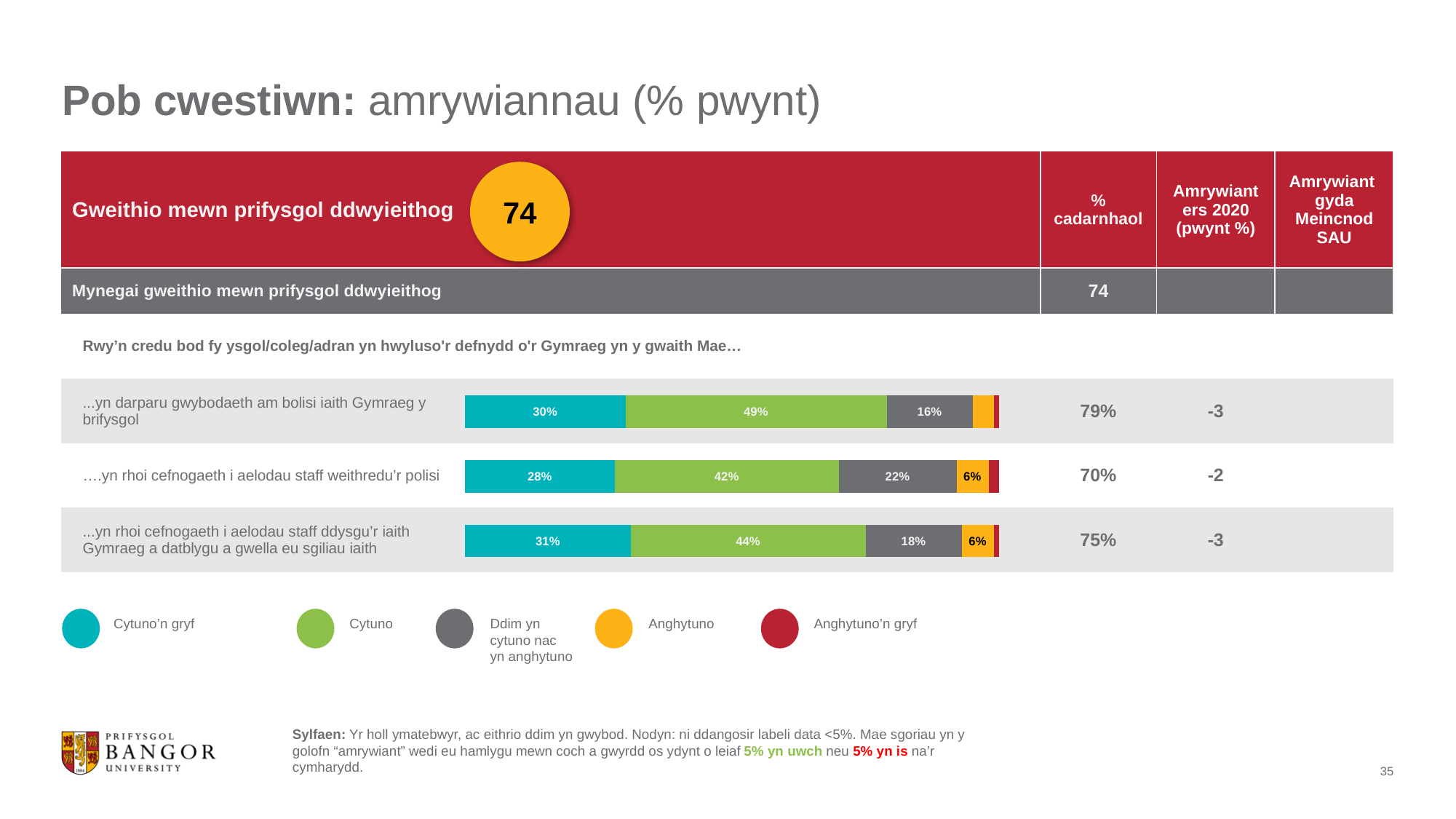
What percentage of respondents strongly agree (Cytuno'n gryf) that the university provides information about the Welsh language policy ("...yn darparu gwybodaeth am bolisi iaith Gymraeg y brifysgol")? 30% What is the Ddim yn cytuno nac yn anghytuno (neither) value for "...yn rhoi cefnogaeth i aelodau staff ddysgu'r iaith Gymraeg a datblygu a gwella eu sgiliau iaith"? 18% Which statement has the highest Cytuno (agree) percentage? ...yn darparu gwybodaeth am bolisi iaith Gymraeg y brifysgol Which is larger: the Ddim yn cytuno nac yn anghytuno value for "….yn rhoi cefnogaeth i aelodau staff weithredu'r polisi" or for "...yn darparu gwybodaeth am bolisi iaith Gymraeg y brifysgol"? ….yn rhoi cefnogaeth i aelodau staff weithredu'r polisi How many statements (bars) are shown in the chart? 3 Which statement has the lowest Cytuno'n gryf (strongly agree) percentage? ….yn rhoi cefnogaeth i aelodau staff weithredu'r polisi How many response categories does the legend list? 5 What kind of chart is used to show the responses? Stacked bar chart What is the Cytuno (agree) value for "….yn rhoi cefnogaeth i aelodau staff weithredu'r polisi"? 42% Which colour represents Anghytuno'n gryf (strongly disagree) in the legend? Red What is the Anghytuno (disagree) value for "….yn rhoi cefnogaeth i aelodau staff weithredu'r polisi"? 6% What is the difference between the Cytuno (agree) values for "...yn darparu gwybodaeth am bolisi iaith Gymraeg y brifysgol" and "….yn rhoi cefnogaeth i aelodau staff weithredu'r polisi"? 7 percentage points